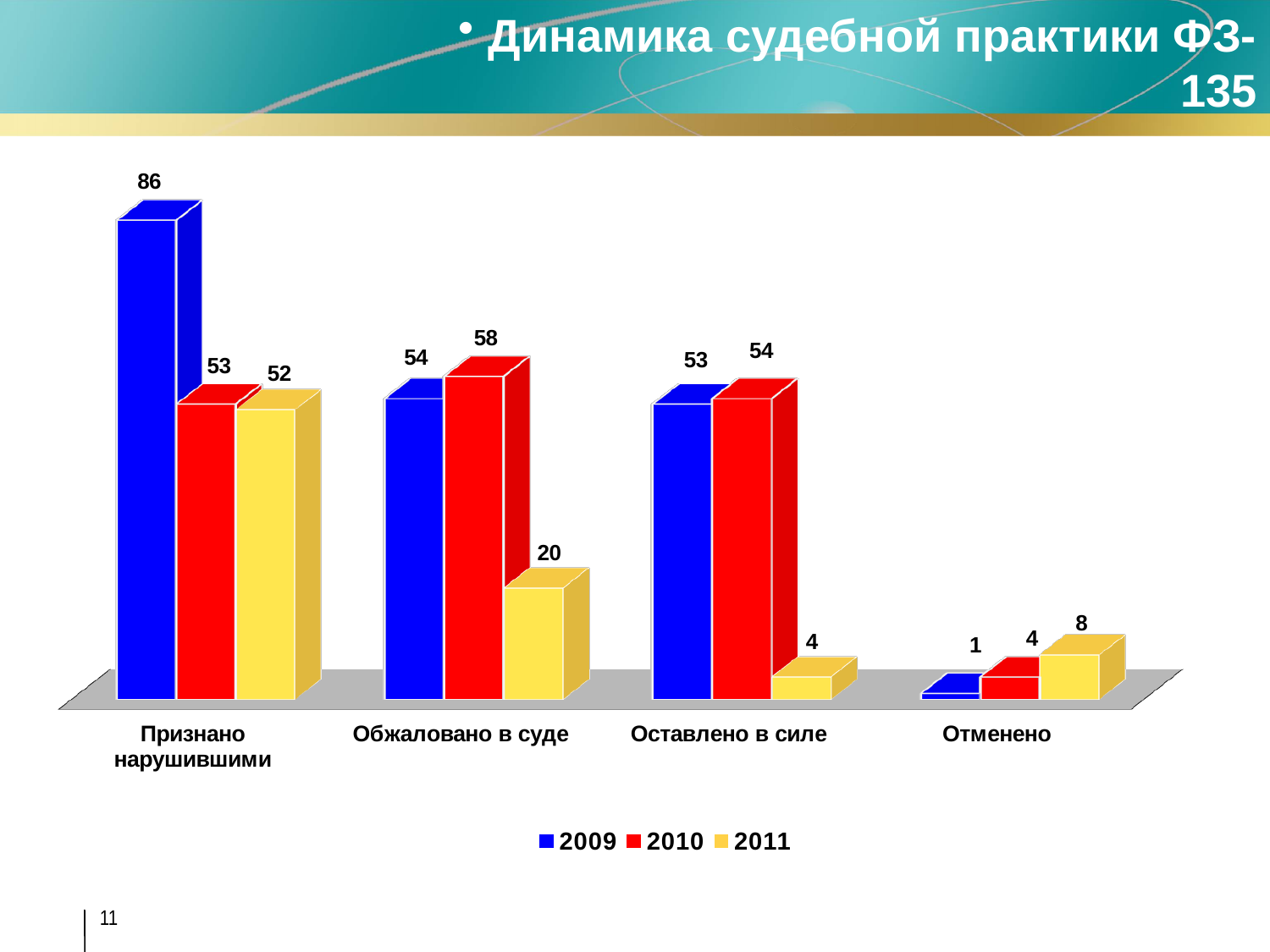
What is the value for 2011 in the 'Обжаловано в суде' category? 20 What is the value for 2010 in the 'Оставлено в силе' category? 54 What is the value for 2011 in the 'Отменено' category? 8 How many series does the legend list? 3 Which colour represents the 2011 series in the legend? Yellow How many categories are shown on the x axis? 4 Which is larger in the 'Обжаловано в суде' category: the 2009 value or the 2010 value? 2010 Which category has the highest value for the 2009 series? Признано нарушившими Which category has the lowest value for the 2011 series? Оставлено в силе What is the value for 2009 in the 'Признано нарушившими' category? 86 What is the difference between the 2009 and 2010 values in the 'Признано нарушившими' category? 33 What kind of chart is shown on the slide? Bar chart